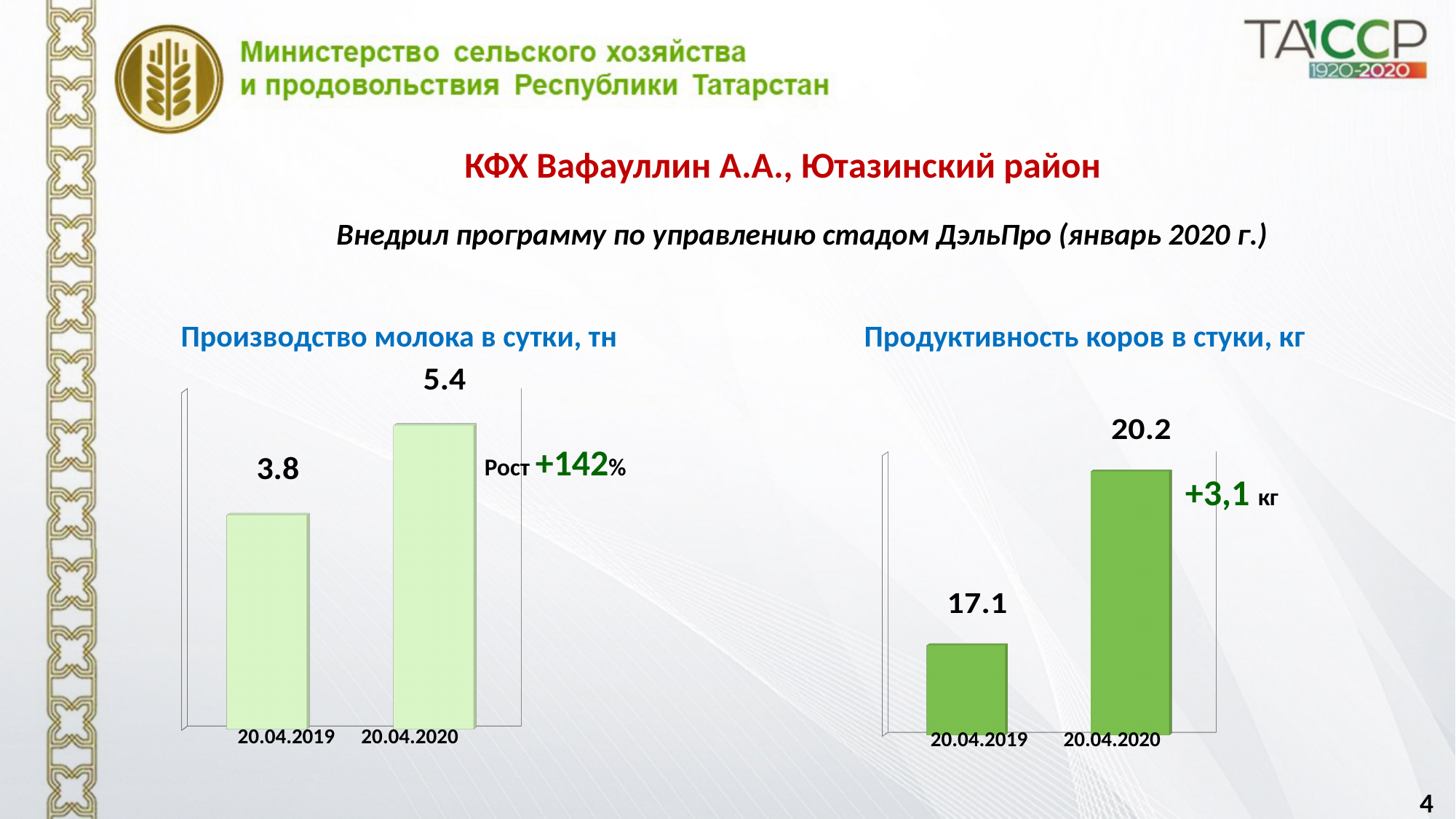
In the chart 'Производство молока в сутки, тн', do the values rise or fall from 20.04.2019 to 20.04.2020? rise How many bars are shown in the chart 'Производство молока в сутки, тн'? 2 In the chart 'Продуктивность коров в стуки, кг', which date has the lower value? 20.04.2019 In the chart 'Производство молока в сутки, тн', what is the value for 20.04.2019? 3.8 In the chart 'Продуктивность коров в стуки, кг', what is the value for 20.04.2019? 17.1 In the chart 'Производство молока в сутки, тн', what is the value for 20.04.2020? 5.4 In the chart 'Производство молока в сутки, тн', what is the difference between the values for 20.04.2020 and 20.04.2019? 1.6 In the chart 'Продуктивность коров в стуки, кг', is the value for 20.04.2020 larger or smaller than the value for 20.04.2019? larger In the chart 'Производство молока в сутки, тн', which date has the higher value? 20.04.2020 In the chart 'Продуктивность коров в стуки, кг', what is the difference between the values for 20.04.2020 and 20.04.2019? 3.1 In the chart 'Продуктивность коров в стуки, кг', what is the value for 20.04.2020? 20.2 What type of chart is the chart on the right of the slide? bar chart